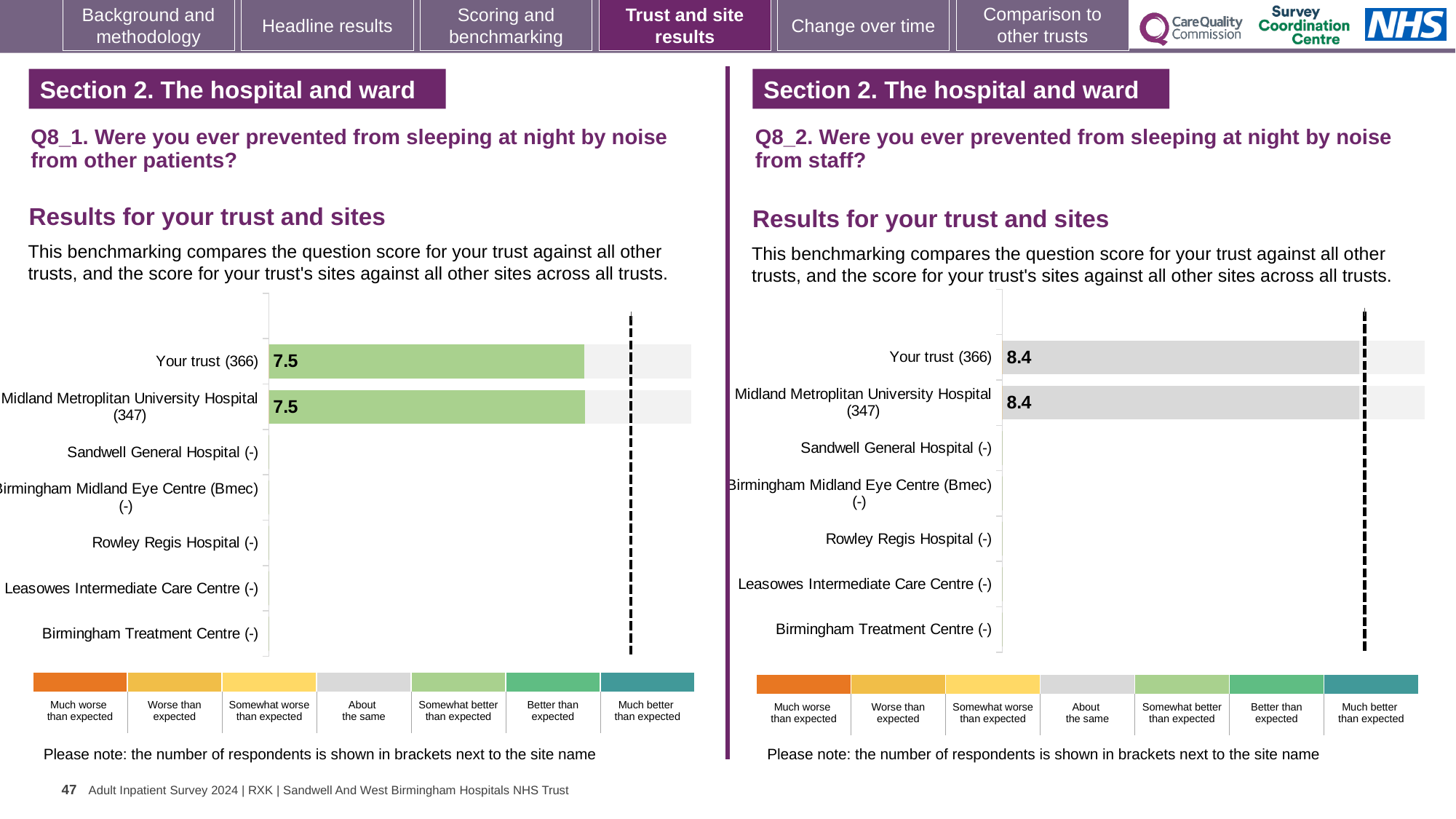
On the Q8_1 chart (noise from other patients), what is the score for Your trust (366)? 7.5 On the Q8_1 chart (noise from other patients), what is the difference between the score for Your trust and the score for Midland Metroplitan University Hospital? 0 What kind of chart is used for the Q8_1 results (noise from other patients)? Bar chart On the Q8_1 chart (noise from other patients), which benchmark category does the colour of the Your trust bar correspond to? Somewhat better than expected How many site categories are listed on the Q8_1 chart (noise from other patients)? 7 How many site categories are listed on the Q8_2 chart (noise from staff)? 7 On the Q8_2 chart (noise from staff), what is the difference between the score for Your trust and the score for Midland Metroplitan University Hospital? 0 On the Q8_1 chart (noise from other patients), what is the score for Midland Metroplitan University Hospital (347)? 7.5 On the Q8_2 chart (noise from staff), which benchmark category does the colour of the Your trust bar correspond to? About the same Is the Your trust score on the Q8_2 chart (noise from staff) larger or smaller than the Your trust score on the Q8_1 chart (noise from other patients)? Larger On the Q8_2 chart (noise from staff), what is the score for Midland Metroplitan University Hospital (347)? 8.4 On the Q8_2 chart (noise from staff), what is the score for Your trust (366)? 8.4